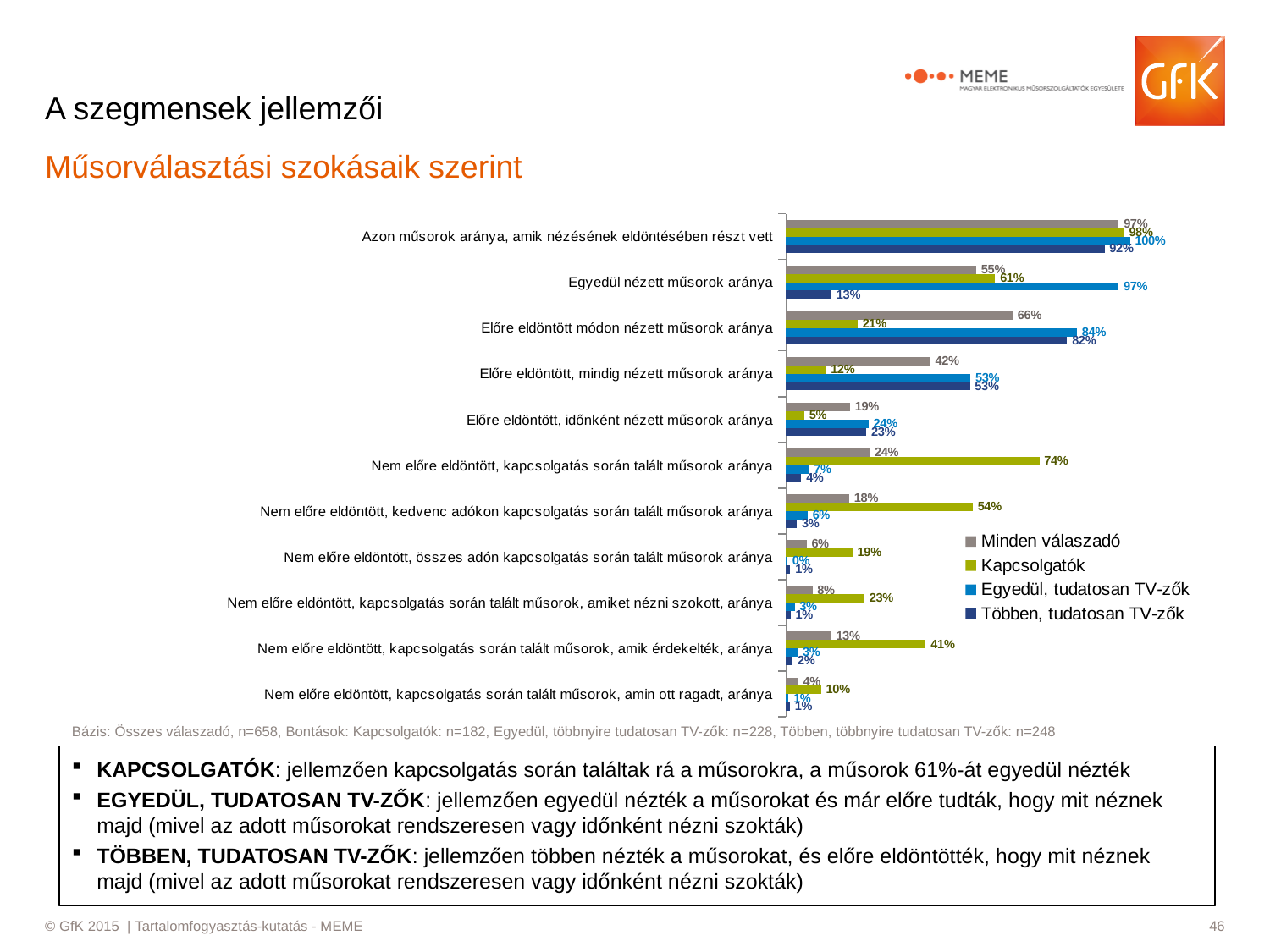
What is the difference between the Egyedül, tudatosan TV-zők value and the Kapcsolgatók value in the category 'Előre eldöntött módon nézett műsorok aránya'? 63% How many series does the legend list? 4 What is the value for Minden válaszadó in the category 'Előre eldöntött módon nézett műsorok aránya'? 66% Which series has the lowest value in the category 'Egyedül nézett műsorok aránya'? Többen, tudatosan TV-zők What type of chart is shown on the slide? bar chart How many categories are plotted on the chart? 11 In the category 'Nem előre eldöntött, kapcsolgatás során talált műsorok, amik érdekelték, aránya', which is larger: the Kapcsolgatók value or the Minden válaszadó value? Kapcsolgatók Which series has the highest value in the category 'Azon műsorok aránya, amik nézésének eldöntésében részt vett'? Egyedül, tudatosan TV-zők Which series is shown in green in the legend? Kapcsolgatók What is the value for Egyedül, tudatosan TV-zők in the category 'Egyedül nézett műsorok aránya'? 97% What is the value for Kapcsolgatók in the category 'Nem előre eldöntött, kapcsolgatás során talált műsorok aránya'? 74% What is the value for Kapcsolgatók in the category 'Egyedül nézett műsorok aránya'? 61%